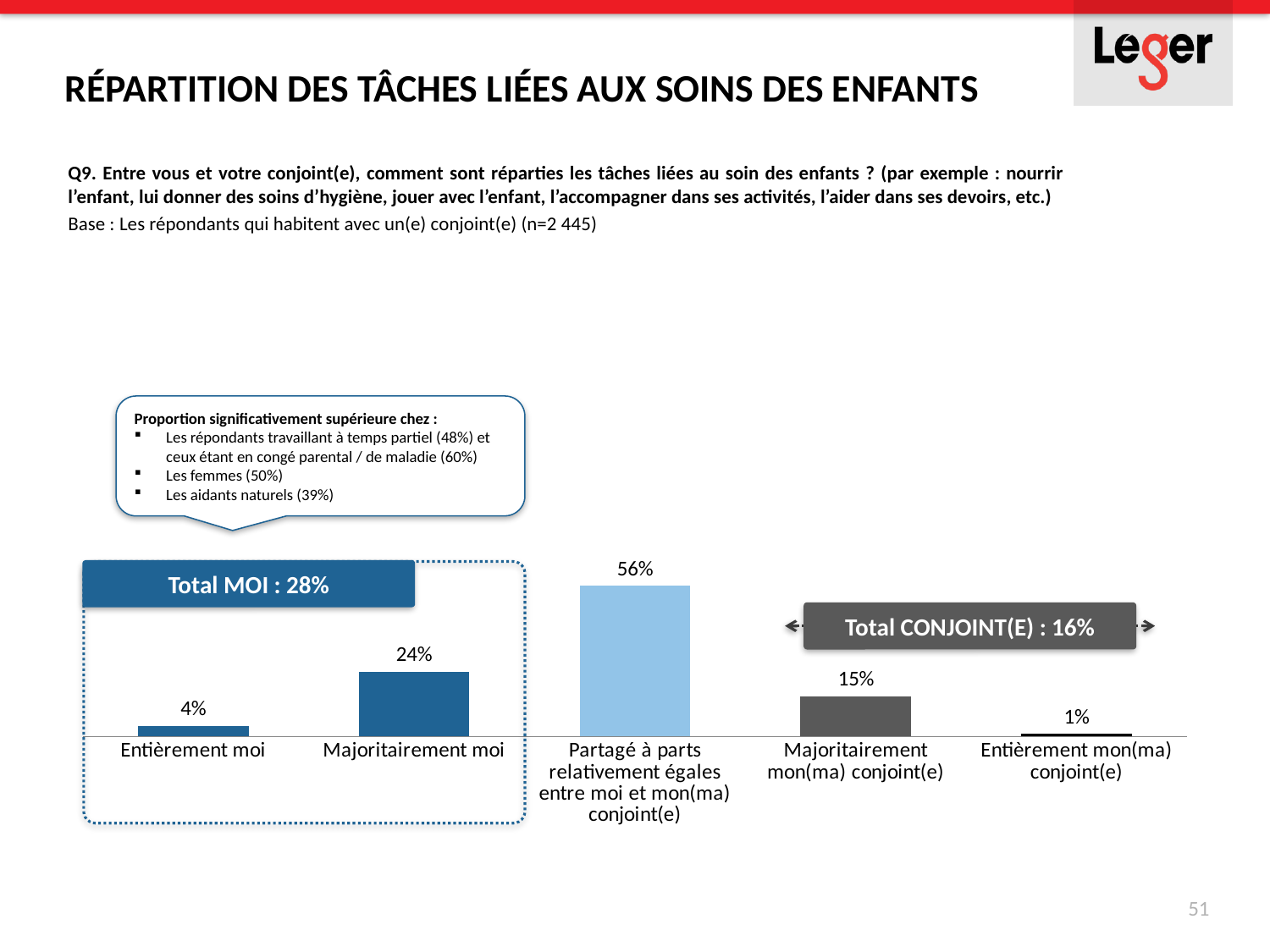
What is the value for "Majoritairement moi"? 24% What is the "Total CONJOINT(E)" value shown on the chart? 16% What is the value for "Partagé à parts relativement égales entre moi et mon(ma) conjoint(e)"? 56% What is the "Total MOI" value shown in the box above the chart? 28% What is the value for "Majoritairement mon(ma) conjoint(e)"? 15% What kind of chart is shown on the slide? Bar chart Which category has the highest value? Partagé à parts relativement égales entre moi et mon(ma) conjoint(e) How many categories are shown in the chart? 5 What is the difference between "Majoritairement moi" and "Majoritairement mon(ma) conjoint(e)"? 9% Which category has the lowest value? Entièrement mon(ma) conjoint(e) What is the value for "Entièrement mon(ma) conjoint(e)"? 1% Which is larger, "Entièrement moi" or "Majoritairement mon(ma) conjoint(e)"? Majoritairement mon(ma) conjoint(e)